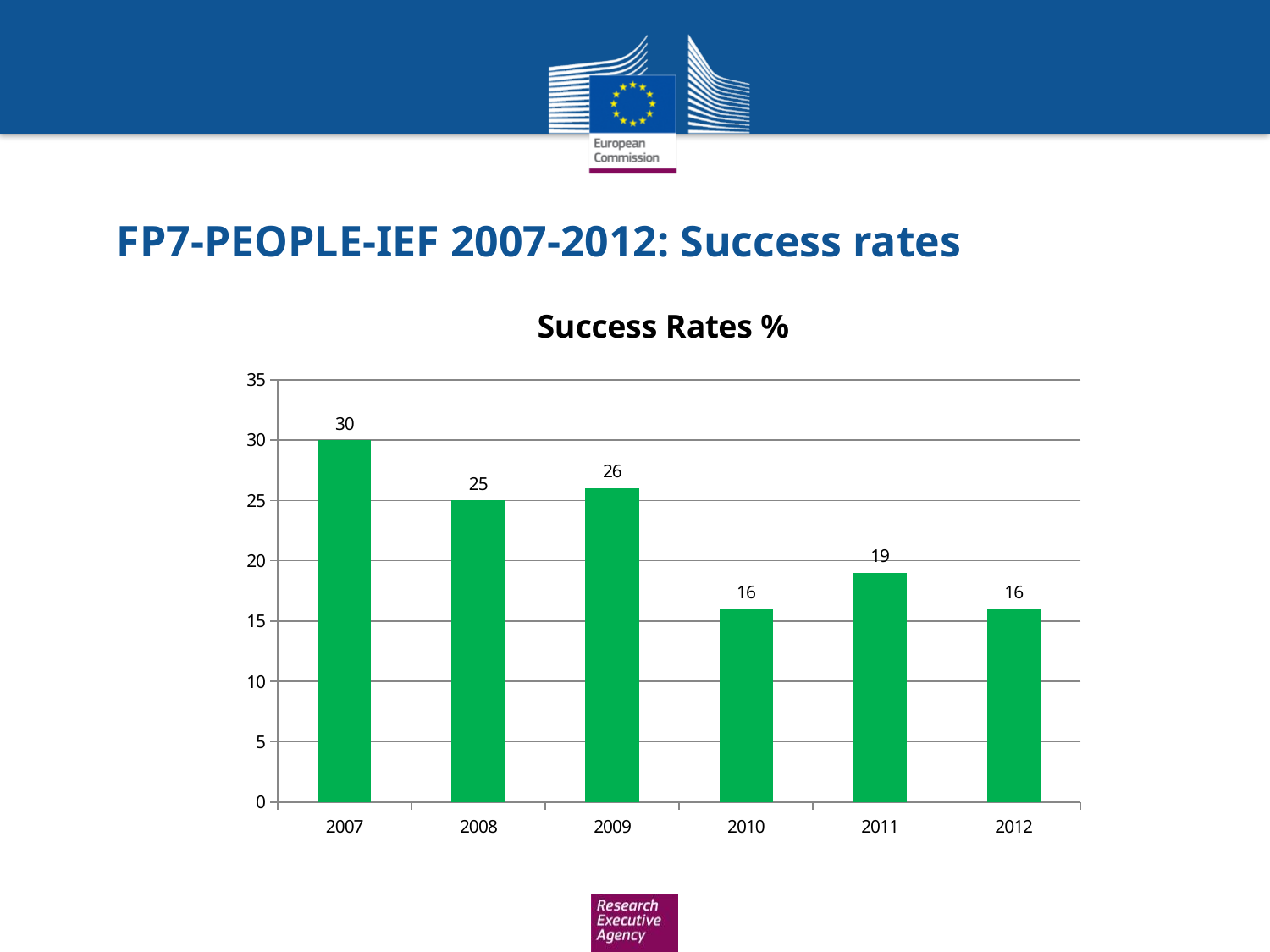
What is the success rate for 2009? 26 Which years share the lowest success rate? 2010 and 2012 What is the success rate for 2011? 19 What is the success rate for 2007? 30 How many years are shown on the x axis? 6 What is the difference between the success rates for 2009 and 2008? 1 Do the success rates generally rise or fall from 2007 to 2012? Fall What is the difference between the success rates for 2007 and 2012? 14 Which year has the highest success rate? 2007 Which year has a higher success rate, 2008 or 2011? 2008 What is the title of the chart? Success Rates % What kind of chart is shown on the slide? Bar chart